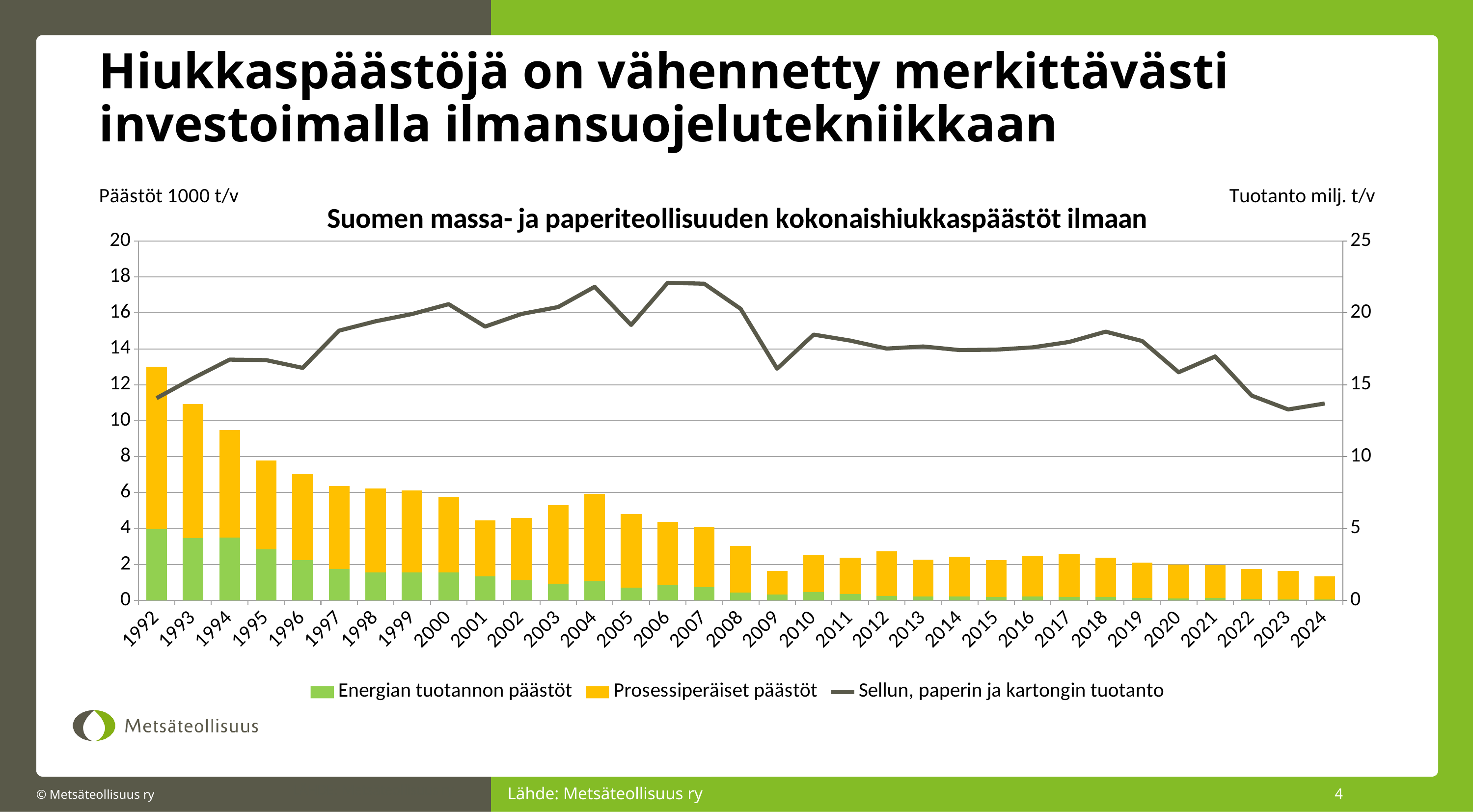
Which year has higher total emissions, 2003 or 2004? 2004 Which year has the lowest total emissions (shortest stacked bar)? 2024 What kind of chart is used to show the emissions series (Energian tuotannon päästöt and Prosessiperäiset päästöt)? bar chart Do the total emissions bars generally rise or fall from 1992 to 2024? fall Is the total emissions value for 2009 greater or less than 2? less Is the total emissions value for 1992 greater or less than 12? greater How many years are shown on the x axis of the chart? 33 How many series does the chart legend list? 3 What is the title of the chart? Suomen massa- ja paperiteollisuuden kokonaishiukkaspäästöt ilmaan Is the value of Sellun, paperin ja kartongin tuotanto for 2006 greater or less than 20 on the right axis? greater Which year has the highest total emissions (tallest stacked bar)? 1992